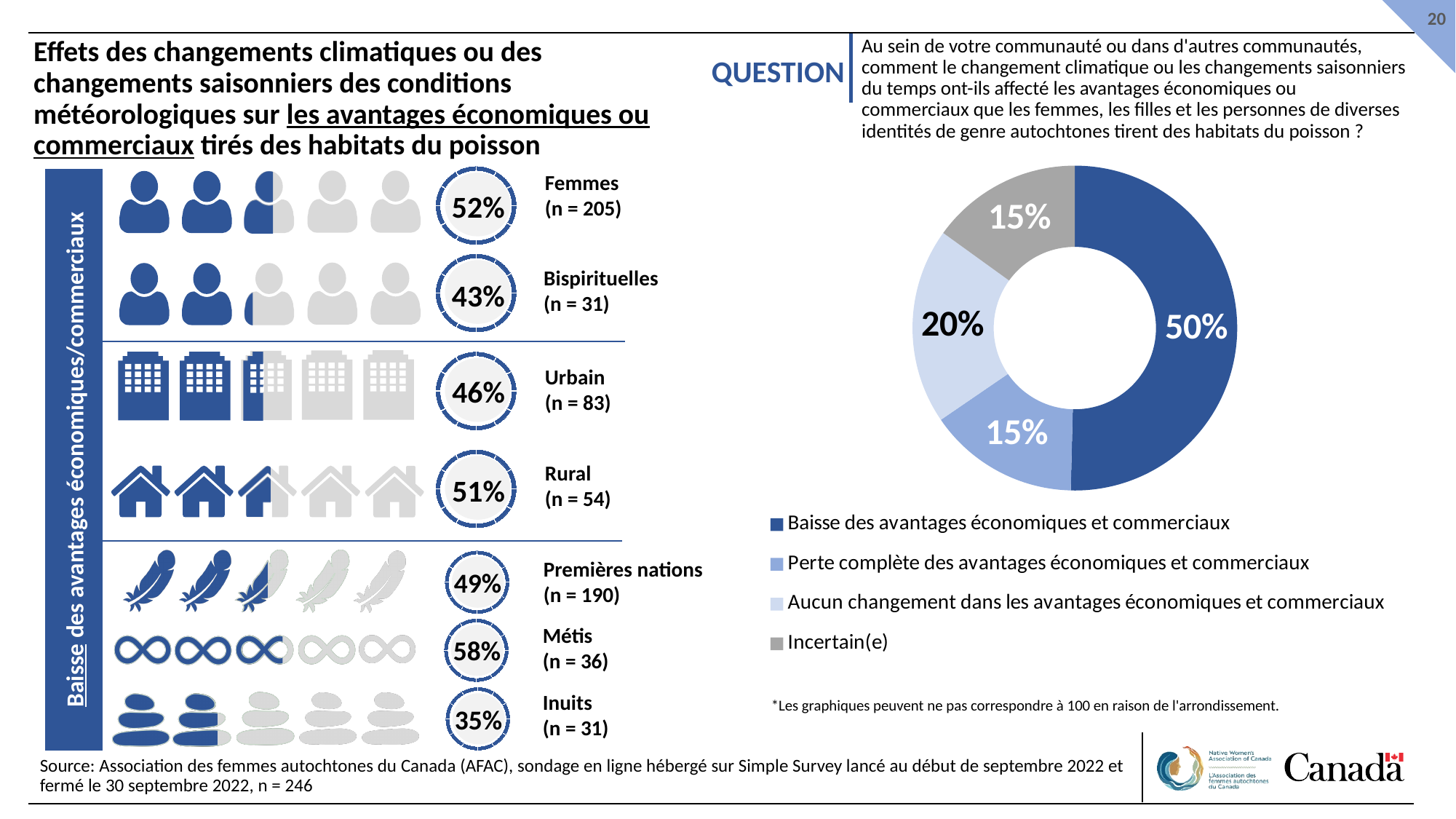
In the pictograph on the left, which is larger: the percentage for Urbain or for Rural? Rural In the donut chart on the right, which category has the largest share? Baisse des avantages économiques et commerciaux In the donut chart on the right, what percentage is shown for 'Incertain(e)'? 15% In the pictograph on the left, which group has the lowest percentage? Inuits In the pictograph on the left, what percentage is shown for Métis? 58% In the pictograph on the left, how many groups are shown with a percentage? 7 In the donut chart on the right, what share of respondents reported 'Baisse des avantages économiques et commerciaux'? 50% In the donut chart on the right, what percentage corresponds to 'Aucun changement dans les avantages économiques et commerciaux'? 20% In the donut chart on the right, what is the difference between the share for 'Baisse des avantages économiques et commerciaux' and the share for 'Aucun changement dans les avantages économiques et commerciaux'? 30% How many entries does the legend of the donut chart on the right list? 4 In the pictograph on the left, what percentage is shown for Inuits? 35% What type of chart is shown on the right side of the slide? Donut chart